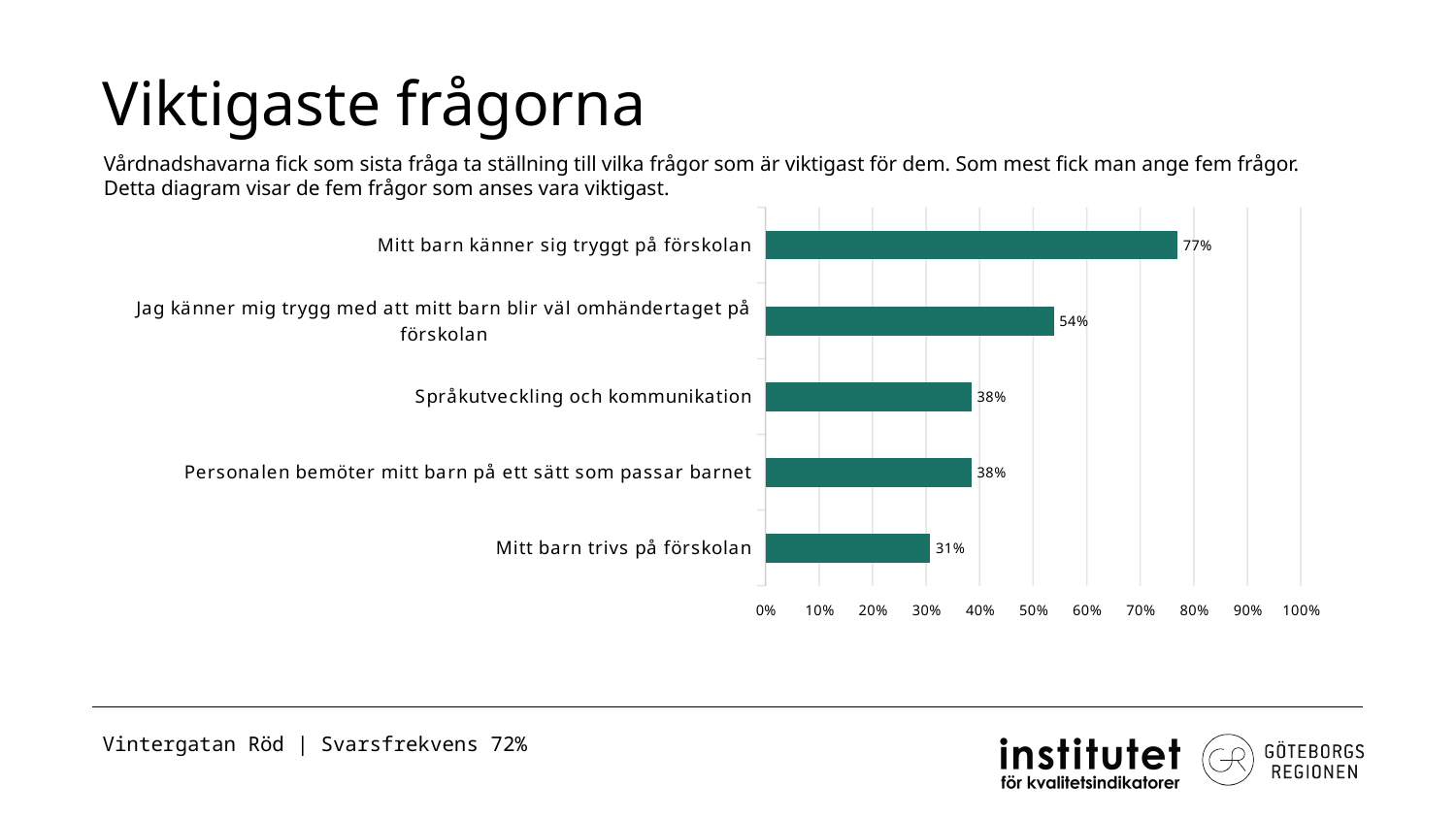
What is the value for "Jag känner mig trygg med att mitt barn blir väl omhändertaget på förskolan"? 54% Which is larger: the value for "Språkutveckling och kommunikation" or the value for "Mitt barn trivs på förskolan"? Språkutveckling och kommunikation What kind of chart is shown on the slide? bar chart What is the value for "Mitt barn känner sig tryggt på förskolan"? 77% Which category has the highest value? Mitt barn känner sig tryggt på förskolan What is the difference between the values for "Mitt barn känner sig tryggt på förskolan" and "Jag känner mig trygg med att mitt barn blir väl omhändertaget på förskolan"? 23% What is the value for "Språkutveckling och kommunikation"? 38% What is the value for "Mitt barn trivs på förskolan"? 31% Which category has the lowest value? Mitt barn trivs på förskolan How many categories are shown in the chart? 5 What is the title of the slide? Viktigaste frågorna Is the value for "Jag känner mig trygg med att mitt barn blir väl omhändertaget på förskolan" greater or less than 50%? greater